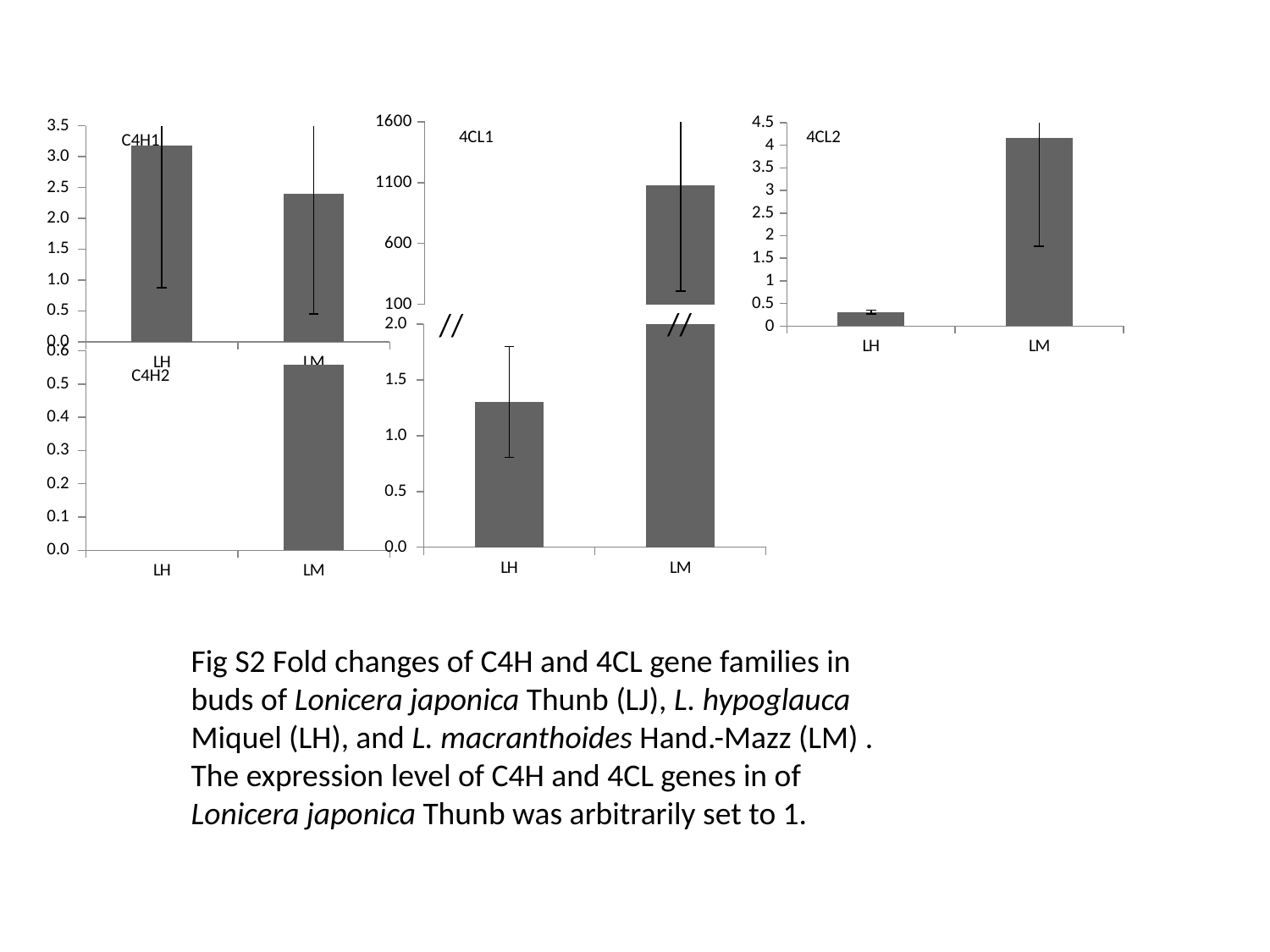
In the C4H2 chart, which category has the highest value? LM In the 4CL1 chart, is the value for LM greater or less than 600? greater In the C4H1 chart, is the value for LH greater or less than 2.5? greater How many categories are shown on the x axis of the 4CL2 chart? 2 In the 4CL2 chart, is the value for LM greater or less than 3.5? greater How many separate charts are shown on the slide? 4 In the 4CL2 chart, which category has the lowest value? LH What kind of chart is the C4H1 chart? bar chart In the C4H1 chart, which category has the higher value, LH or LM? LH